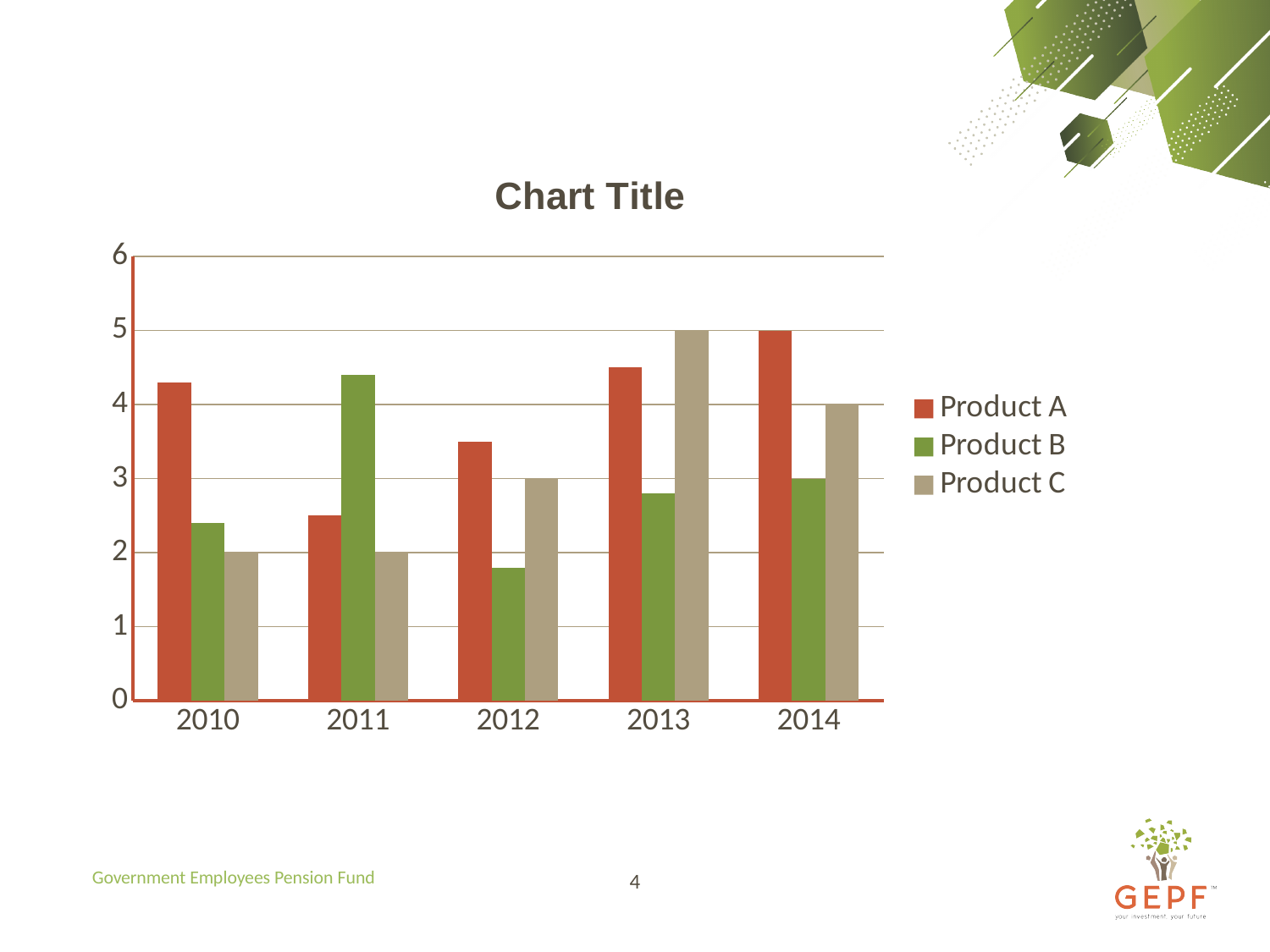
In which year is Product C highest? 2013 In which year is Product B lowest? 2012 How many years are shown on the x axis? 5 Is the value for Product A in 2010 greater or less than 4? greater What is the value for Product B in 2014? 3 What is the difference between Product C in 2013 and Product C in 2012? 2 What kind of chart is shown on the slide? bar chart What is the value for Product C in 2010? 2 What is the value for Product C in 2013? 5 What is the value for Product A in 2014? 5 Which is larger in 2011, Product A or Product B? Product B How many series does the legend list? 3